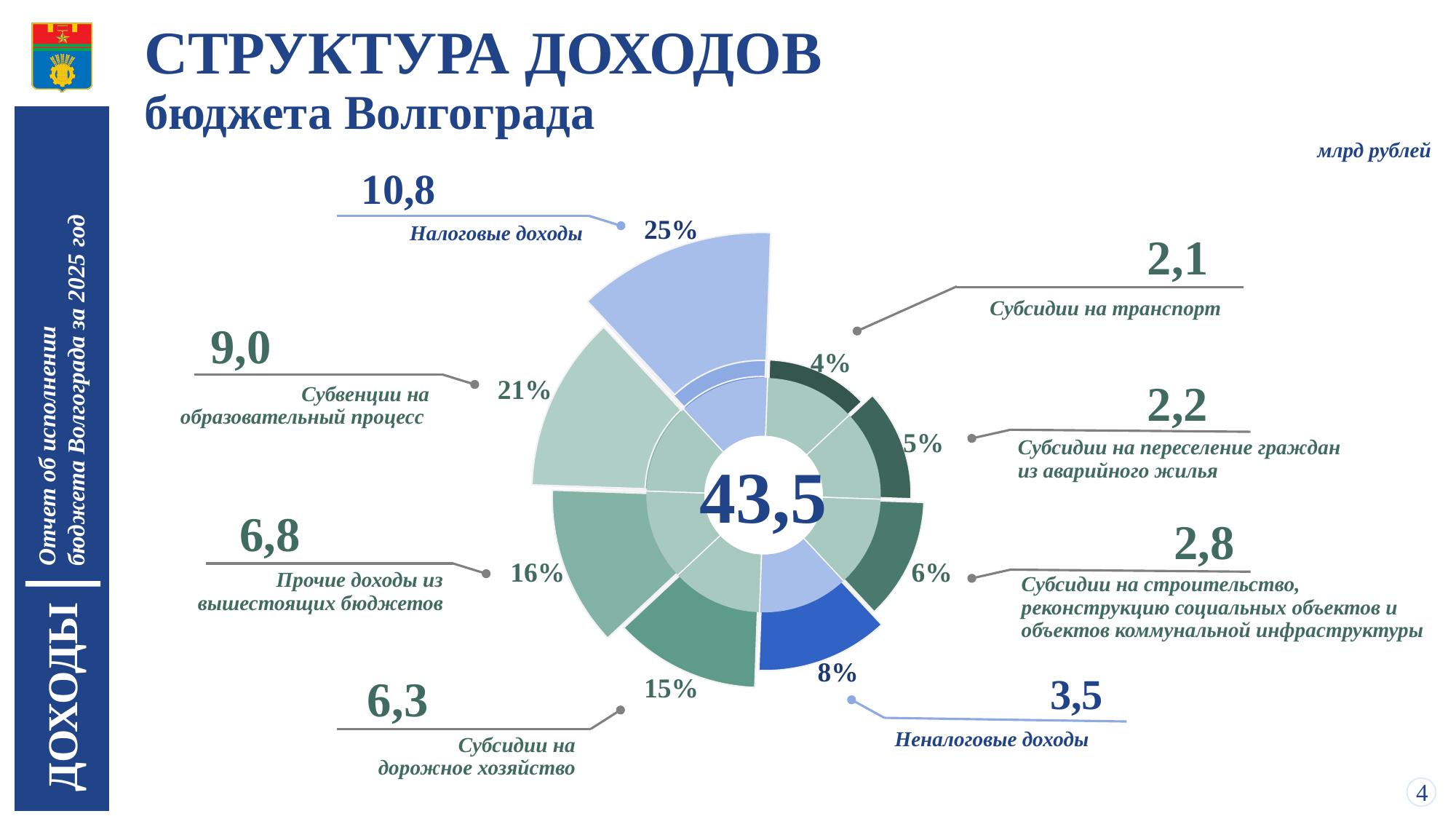
Какова общая сумма доходов бюджета, указанная в центре диаграммы? 43,5 Какая категория доходов является наибольшей по величине? Налоговые доходы Какой тип диаграммы использован на слайде? Круговая (кольцевая) диаграмма Какая доля приходится на неналоговые доходы? 8% Какова величина налоговых доходов бюджета Волгограда (млрд рублей)? 10,8 В каких единицах измерения приведены значения на диаграмме? млрд рублей Какую долю в структуре доходов занимают субвенции на образовательный процесс? 21% Сколько категорий доходов показано на диаграмме? 8 Сколько млрд рублей составляют субсидии на дорожное хозяйство? 6,3 На сколько млрд рублей налоговые доходы превышают неналоговые доходы? 7,3 Что больше: субсидии на переселение граждан из аварийного жилья или субсидии на транспорт? Субсидии на переселение граждан из аварийного жилья Какая категория доходов является наименьшей по величине? Субсидии на транспорт